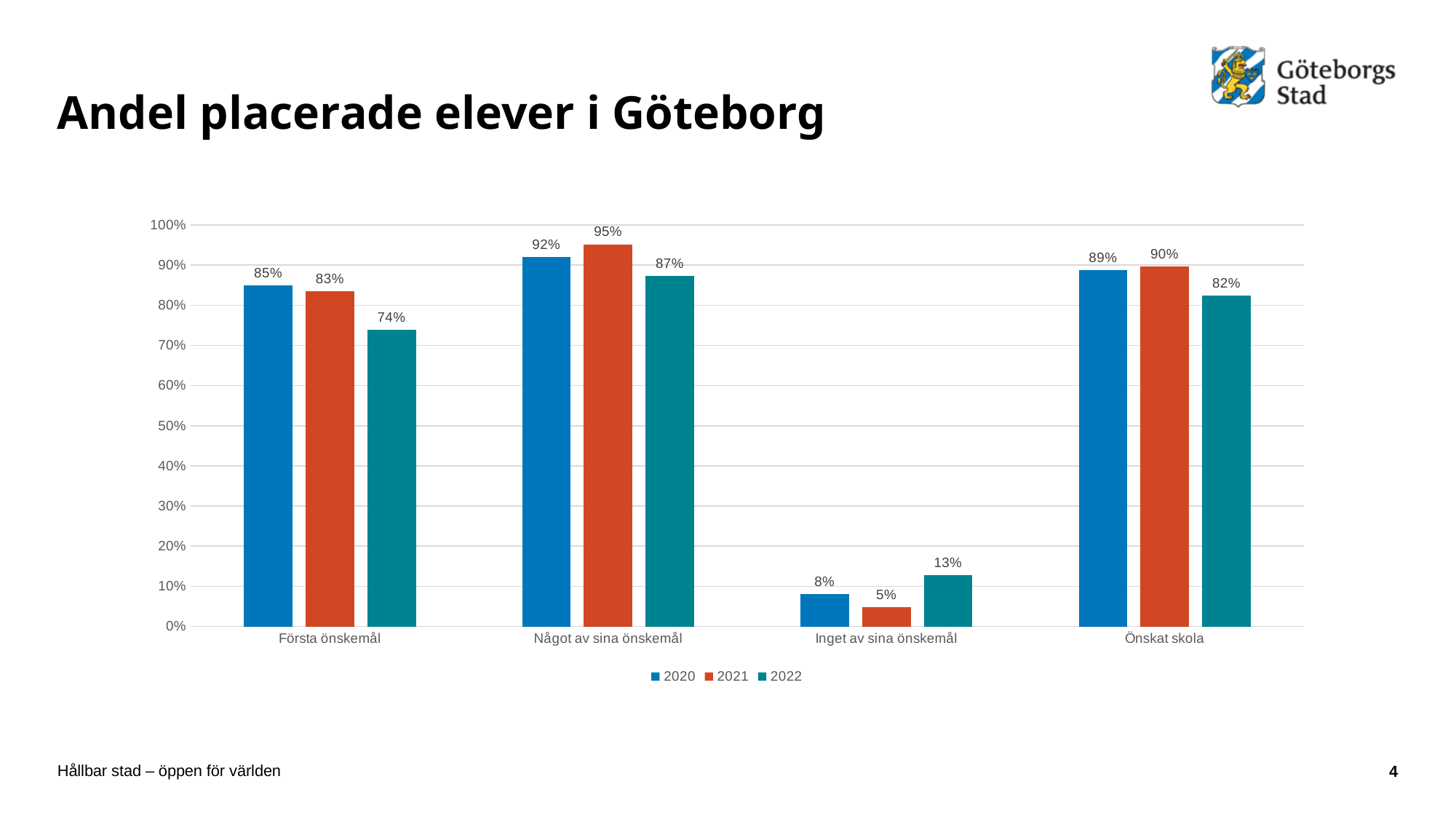
What kind of chart is shown on the slide? Bar chart What is the value for 2020 in the Inget av sina önskemål category? 8% How many categories are shown on the x axis? 4 How many series does the legend list? 3 Which is larger for Något av sina önskemål: the 2020 value or the 2022 value? 2020 What is the difference between the 2020 and 2022 values for Första önskemål? 11% Which year has the lowest value in the Första önskemål category? 2022 What is the value for 2022 in the Önskat skola category? 82% Which year has the highest value in the Inget av sina önskemål category? 2022 What is the title of the slide? Andel placerade elever i Göteborg What is the value for 2021 in the Något av sina önskemål category? 95% What is the value for 2022 in the Första önskemål category? 74%